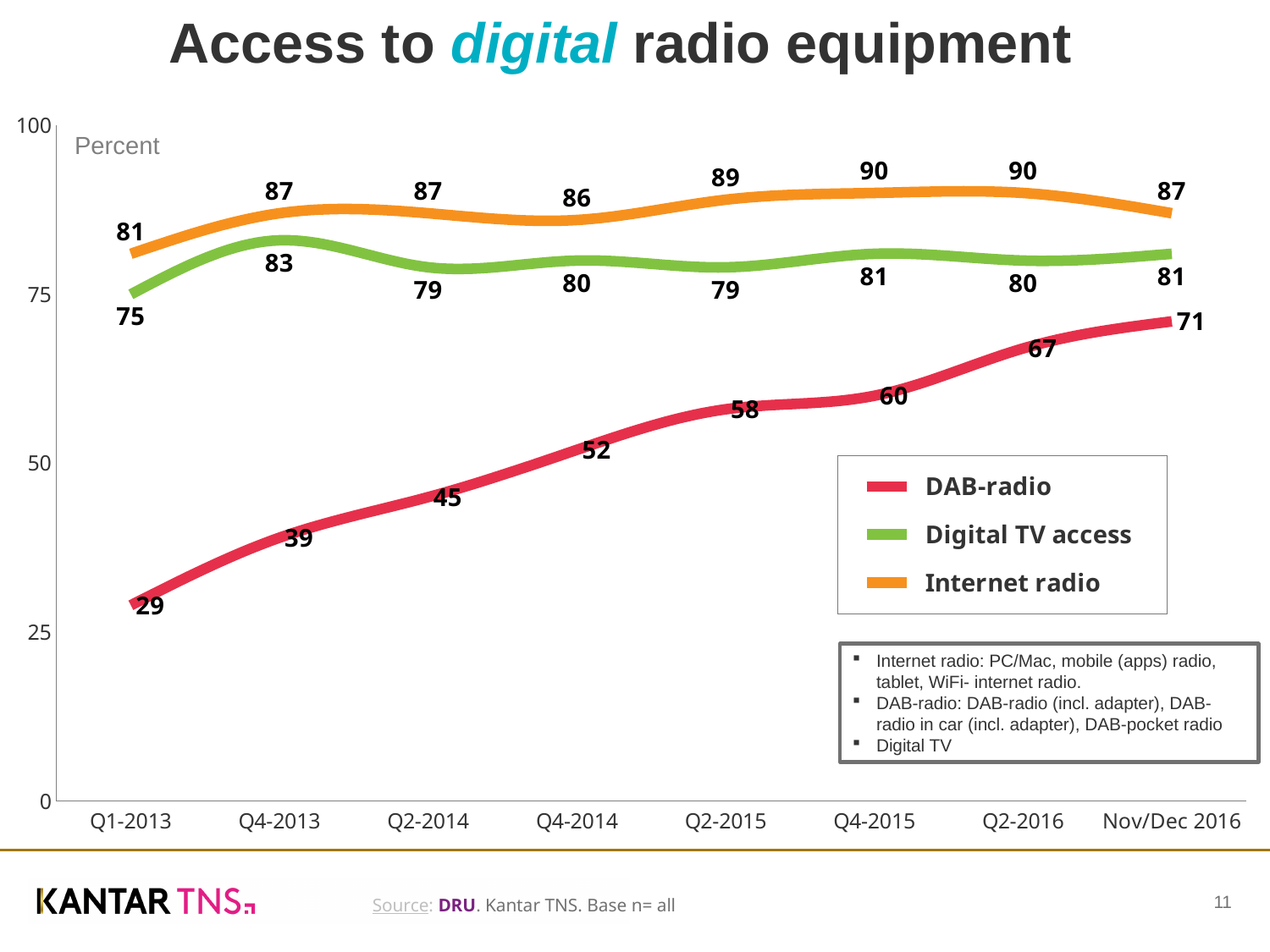
What is the value for DAB-radio at Q1-2013? 29 What is the value for Digital TV access at Nov/Dec 2016? 81 Does the DAB-radio series rise or fall from Q1-2013 to Nov/Dec 2016? Rise What colour is the Internet radio line? Orange At which time point is the Digital TV access value lowest? Q1-2013 What is the value for Internet radio at Q4-2015? 90 How many time points are shown on the x axis? 8 Which is larger at Q4-2013: Internet radio or Digital TV access? Internet radio What kind of chart is shown on the slide? Line chart At which time point is the DAB-radio value highest? Nov/Dec 2016 What is the difference between the DAB-radio values at Nov/Dec 2016 and Q1-2013? 42 How many series does the legend list? 3